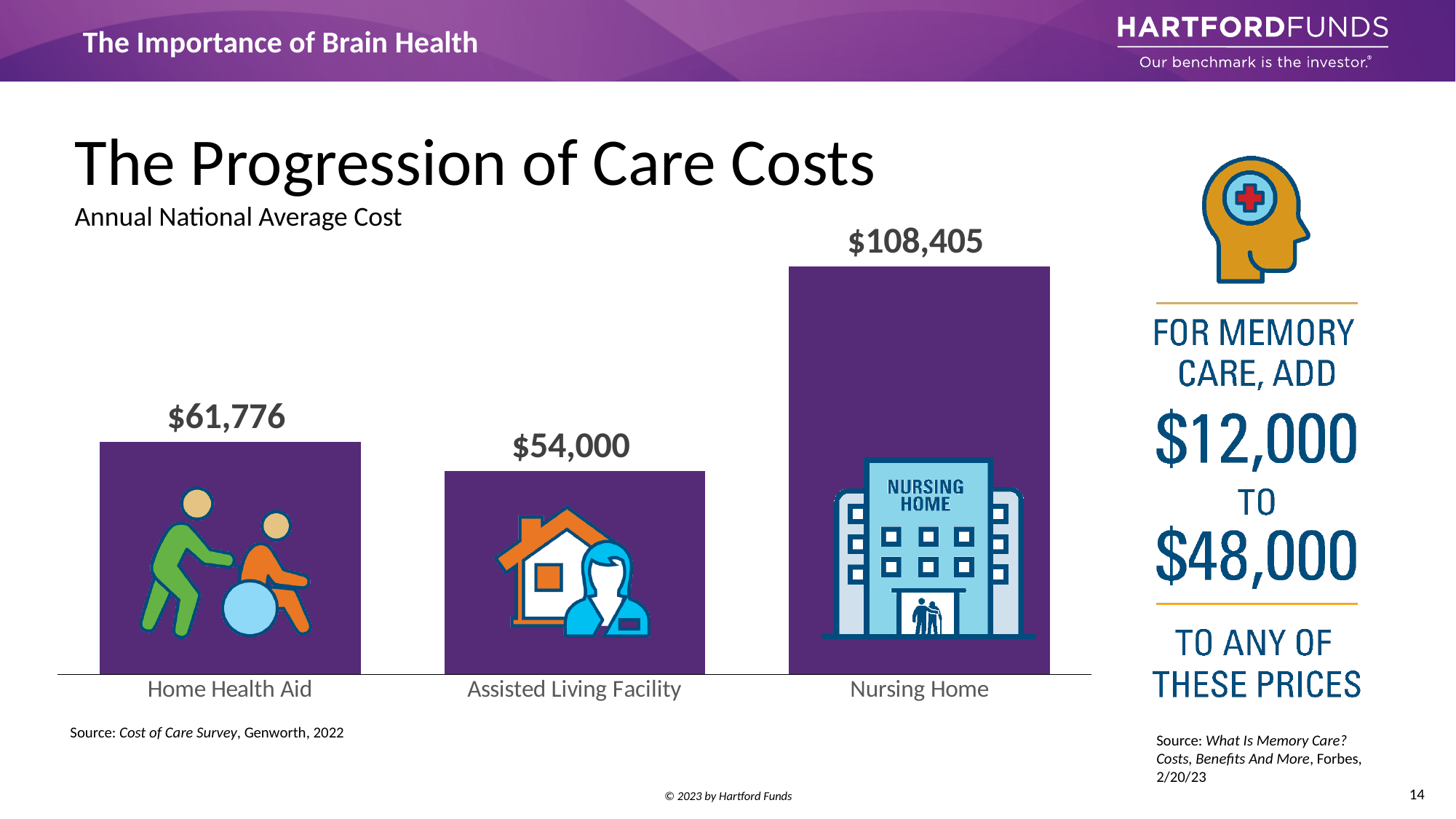
What is the annual national average cost for an Assisted Living Facility? $54,000 What is the source of the chart data? Cost of Care Survey, Genworth, 2022 What is the annual national average cost for a Nursing Home? $108,405 What is the annual national average cost for a Home Health Aid? $61,776 What is the title of the chart? The Progression of Care Costs Which type of care has the highest annual national average cost? Nursing Home What is the difference in annual cost between a Nursing Home and a Home Health Aid? $46,629 Which costs more per year, a Home Health Aid or an Assisted Living Facility? Home Health Aid What is the difference in annual cost between a Home Health Aid and an Assisted Living Facility? $7,776 How many care types are shown in the chart? 3 Which type of care has the lowest annual national average cost? Assisted Living Facility What kind of chart is used to show the progression of care costs? Bar chart